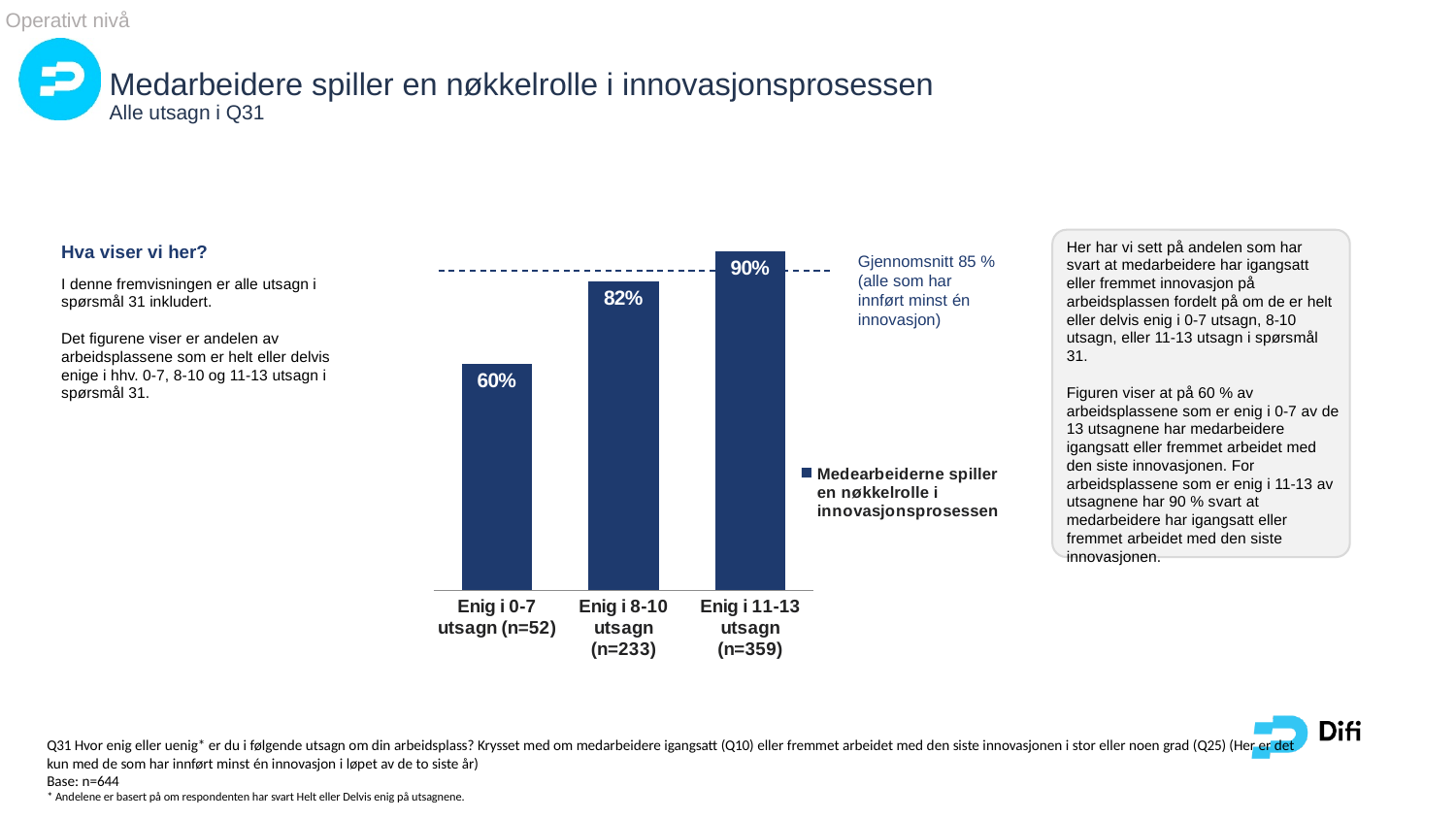
How many categories are shown on the x axis? 3 What kind of chart is shown? Bar chart What is the difference between the values for 'Enig i 11-13 utsagn (n=359)' and 'Enig i 0-7 utsagn (n=52)'? 30% Do the values rise or fall from left to right along the x axis? Rise What is the difference between the values for 'Enig i 8-10 utsagn (n=233)' and 'Enig i 0-7 utsagn (n=52)'? 22% How many series does the legend list? 1 What is the value for 'Enig i 0-7 utsagn (n=52)'? 60% Which category has the lowest value? Enig i 0-7 utsagn (n=52) Which is larger, the value for 'Enig i 8-10 utsagn (n=233)' or 'Enig i 11-13 utsagn (n=359)'? Enig i 11-13 utsagn (n=359) What is the value for 'Enig i 11-13 utsagn (n=359)'? 90% What is the value for 'Enig i 8-10 utsagn (n=233)'? 82% Which category has the highest value? Enig i 11-13 utsagn (n=359)